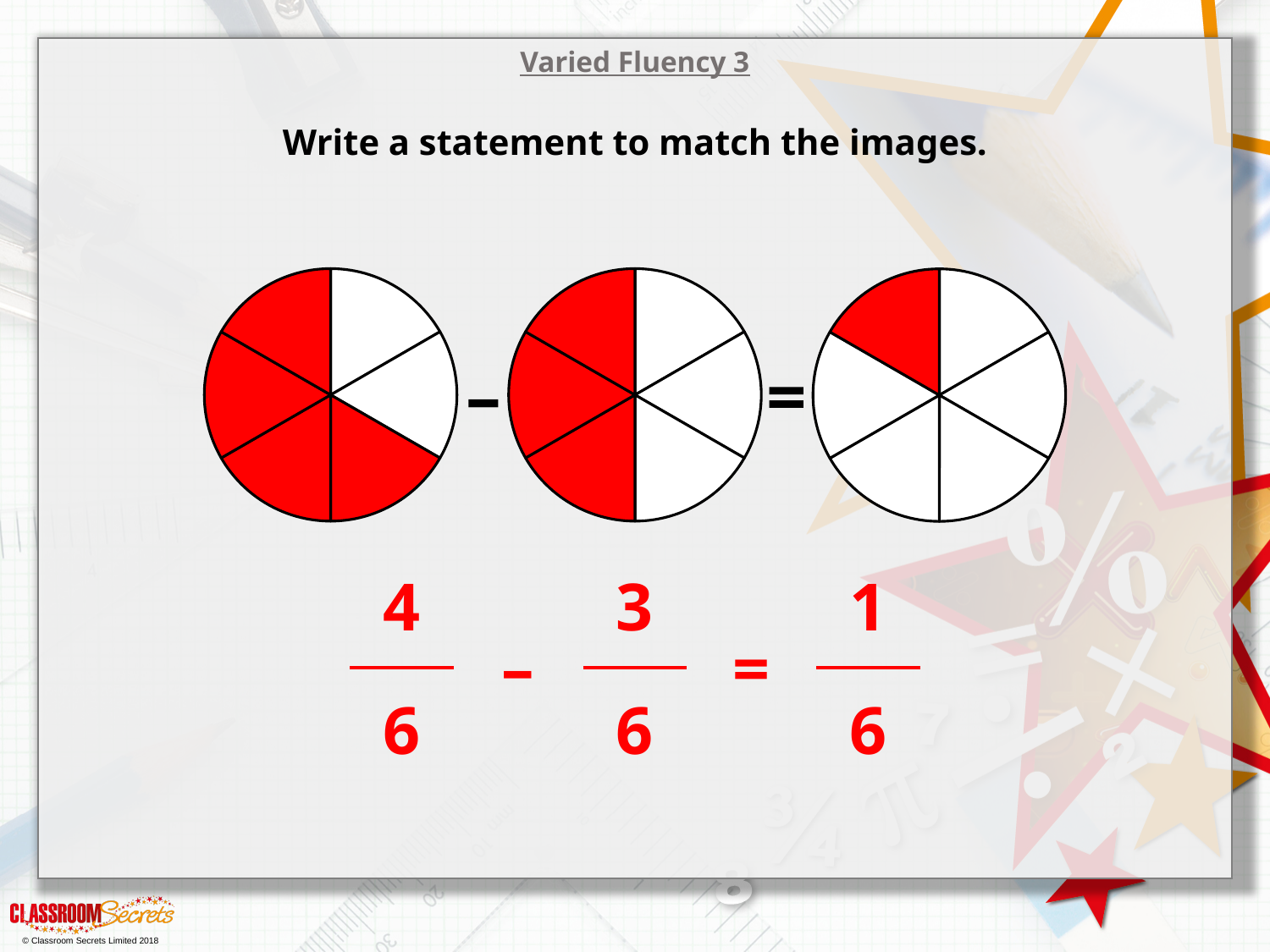
What is the title shown at the top of the slide? Varied Fluency 3 What fraction of the middle circle is shaded red, as written on the slide? 3/6 What colour are the shaded sections of the circles? red What is the difference between the number of red sections in the left circle and the middle circle? 1 What fraction of the right circle is shaded red, as written on the slide? 1/6 How many sections of the middle circle are shaded red? 3 Which circle has the most red sections: the left, middle or right? left What fraction of the left circle is shaded red, as written on the slide? 4/6 Does the left circle or the middle circle have more red sections? left How many sections of the right circle are shaded red? 1 Which circle has the fewest red sections: the left, middle or right? right How many equal sections is the left circle divided into? 6